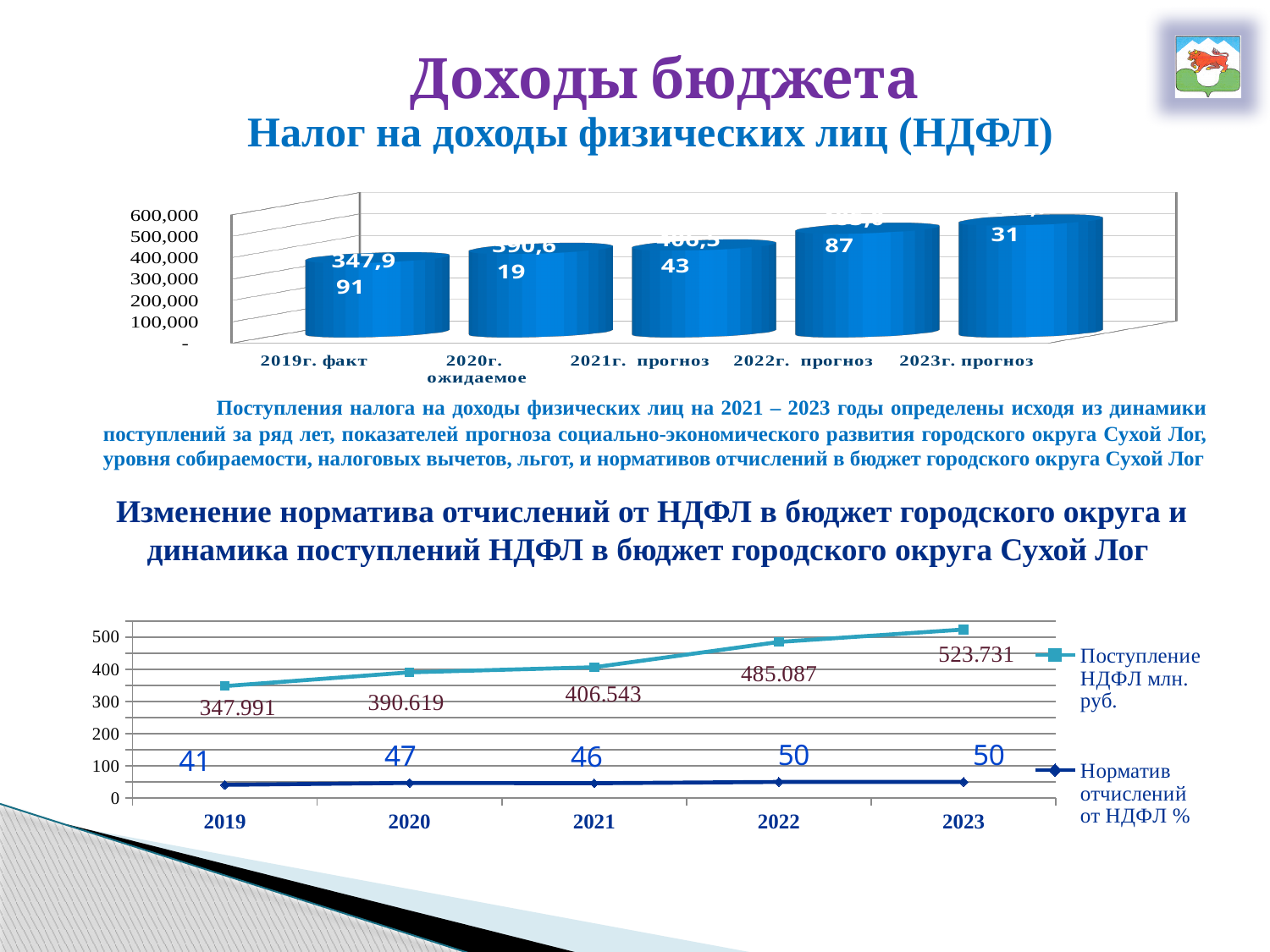
In the bottom line chart, what is the value of Поступление НДФЛ млн. руб. for 2021? 406.543 In the bottom line chart, does the Поступление НДФЛ млн. руб. series rise or fall from 2019 to 2023? rise What kind of chart is the bottom chart on the slide? line chart In the bottom line chart, what is the difference between the Поступление НДФЛ млн. руб. values for 2023 and 2022? 38.644 In the bottom line chart, which year has the highest value of Поступление НДФЛ млн. руб.? 2023 How many series does the legend of the bottom line chart list? 2 What kind of chart is the top chart on the slide? bar chart In the top bar chart, is the value for 2019г. факт greater or less than 300,000? greater In the bottom line chart, which year has the larger Поступление НДФЛ млн. руб. value, 2021 or 2022? 2022 How many years are plotted on the x axis of the bottom line chart? 5 In the bottom line chart, which year has the lowest value of Норматив отчислений от НДФЛ %? 2019 In the bottom line chart, what is the value of Норматив отчислений от НДФЛ % for 2020? 47